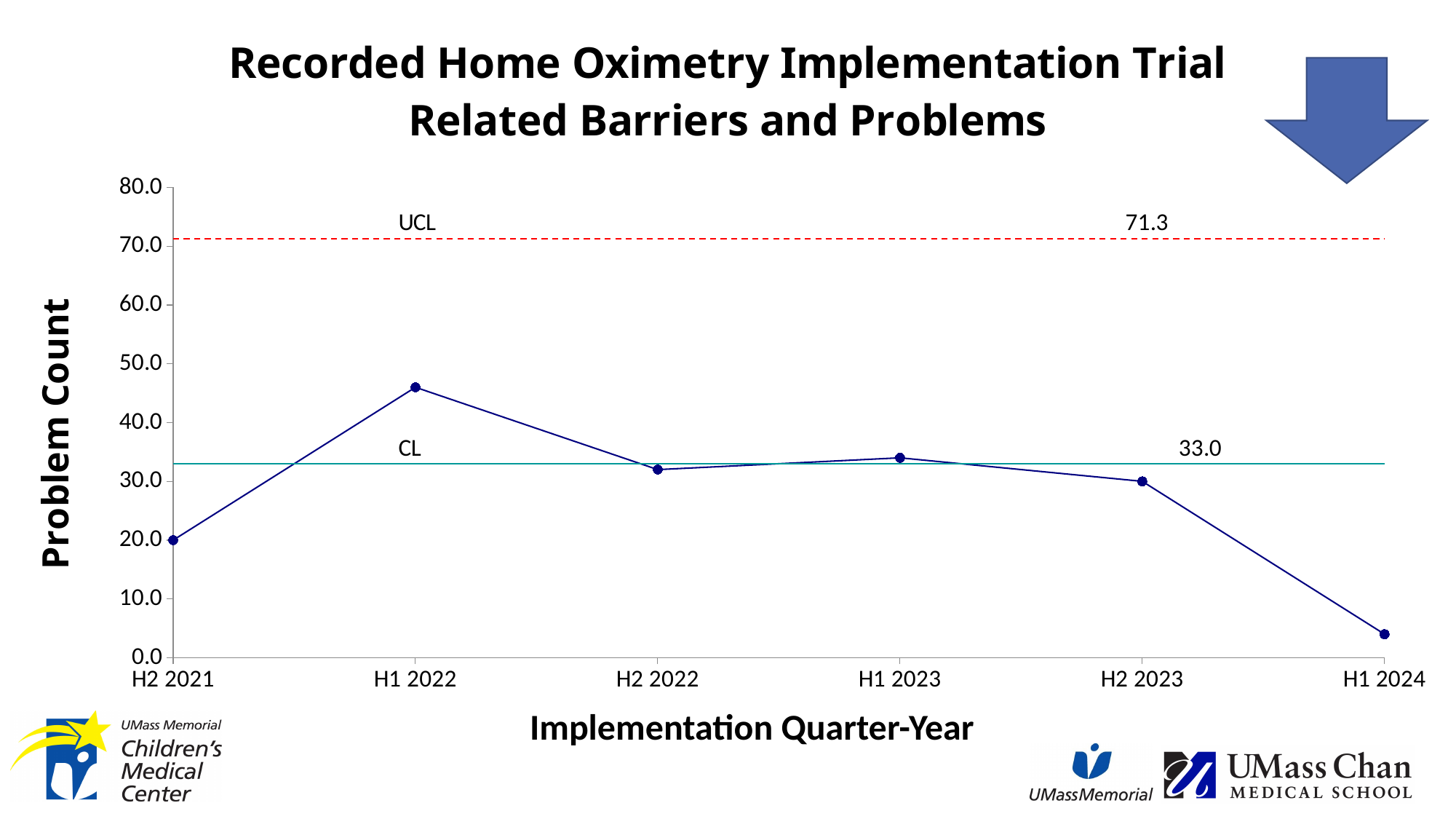
Is the problem count for H2 2021 greater or less than 30.0? less Is the problem count for H1 2024 greater or less than 10.0? less What is the value of the UCL line? 71.3 How many implementation quarter-year points are plotted on the x axis? 6 Which has a larger problem count, H1 2022 or H2 2022? H1 2022 What is the value of the CL line? 33.0 Which implementation quarter-year has the lowest problem count? H1 2024 What is the label of the y axis? Problem Count What type of chart is shown on the slide? line chart Which implementation quarter-year has the highest problem count? H1 2022 Does the problem count rise or fall from H2 2023 to H1 2024? fall Is the problem count for H1 2022 greater or less than 40.0? greater